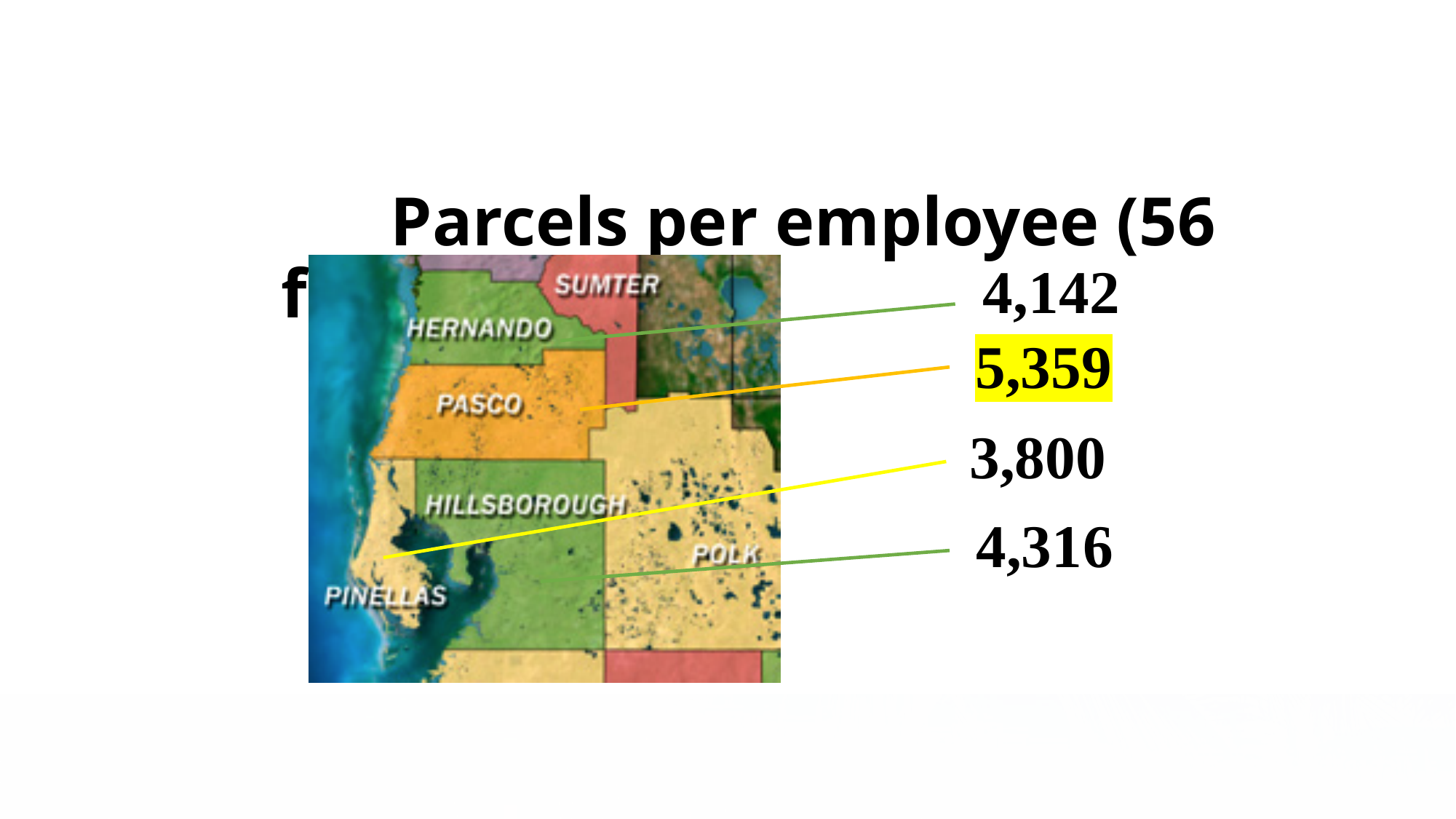
Which value on the slide is highlighted in yellow? 5,359 What is the difference between the values for Pasco and Pinellas? 1,559 What is the parcels-per-employee value shown for Hillsborough County? 4,316 How many counties have a parcels-per-employee value labelled on the map? 4 What is the difference between the values for Hillsborough and Hernando? 174 Which county has the lowest parcels-per-employee value on the map? Pinellas What is the parcels-per-employee value shown for Pasco County? 5,359 Which has the larger value, Pasco or Hillsborough? Pasco What is the parcels-per-employee value shown for Hernando County? 4,142 What is the parcels-per-employee value shown for Pinellas County? 3,800 Which county has the highest parcels-per-employee value on the map? Pasco Which has the larger value, Hillsborough or Hernando? Hillsborough